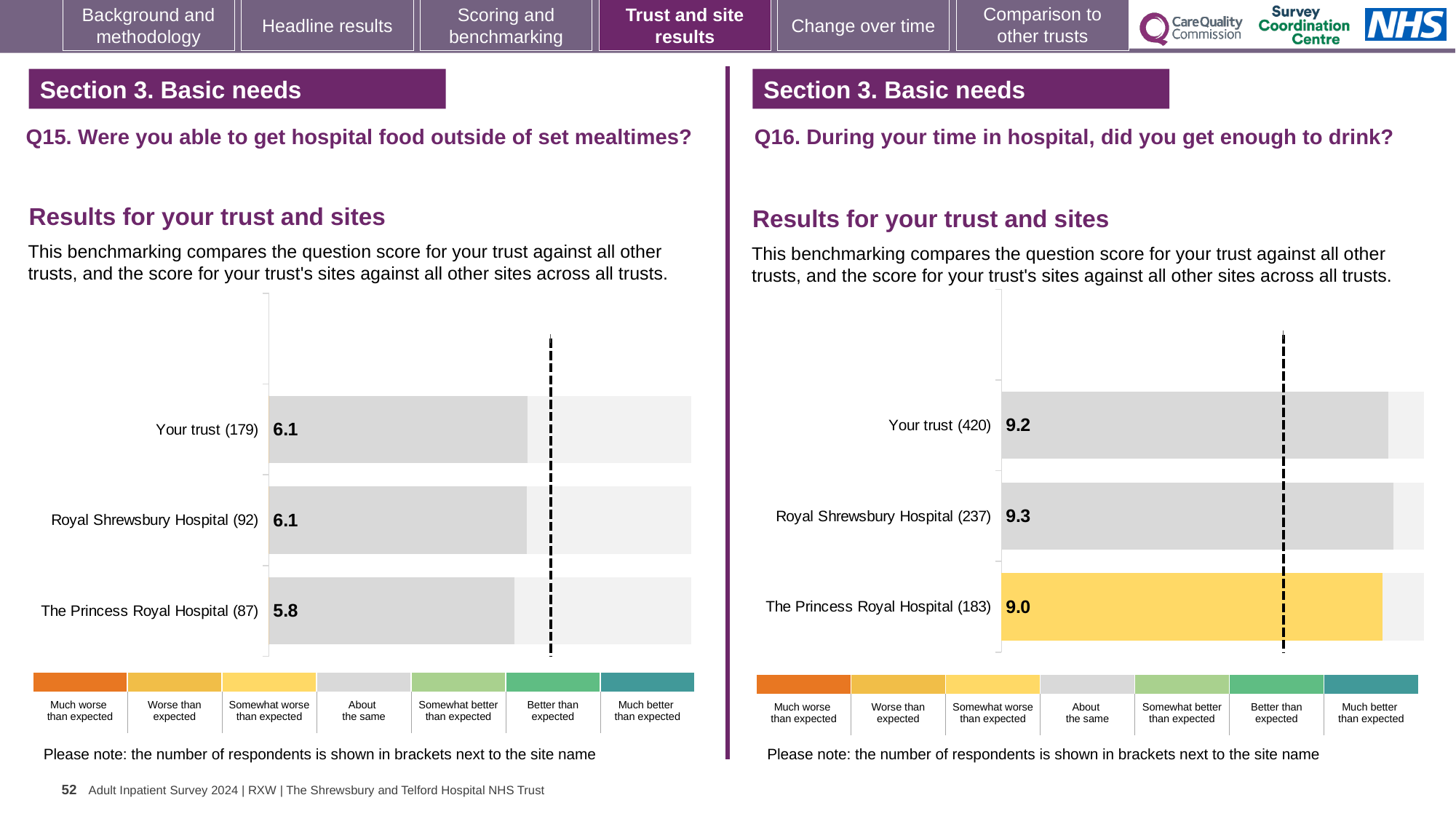
What kind of chart is used on the Q16 chart (right)? Bar chart On the Q16 chart (right), what is the score for Royal Shrewsbury Hospital (237)? 9.3 On the Q16 chart (right), which site or trust has the highest score? Royal Shrewsbury Hospital (237) On the Q16 chart (right), which bar is coloured yellow rather than grey? The Princess Royal Hospital (183) On the Q16 chart (right), what is the difference between the score for Royal Shrewsbury Hospital (237) and The Princess Royal Hospital (183)? 0.3 On the Q15 chart (left), which site or trust has the lowest score? The Princess Royal Hospital (87) On the Q16 chart (right), what is the score for The Princess Royal Hospital (183)? 9.0 On the Q15 chart (left), what is the score for Your trust (179)? 6.1 On the Q15 chart (left), how many bars are plotted? 3 On the Q15 chart (left), what is the difference between the score for Royal Shrewsbury Hospital (92) and The Princess Royal Hospital (87)? 0.3 On the Q16 chart (right), what is the score for Your trust (420)? 9.2 On the Q15 chart (left), what is the score for The Princess Royal Hospital (87)? 5.8